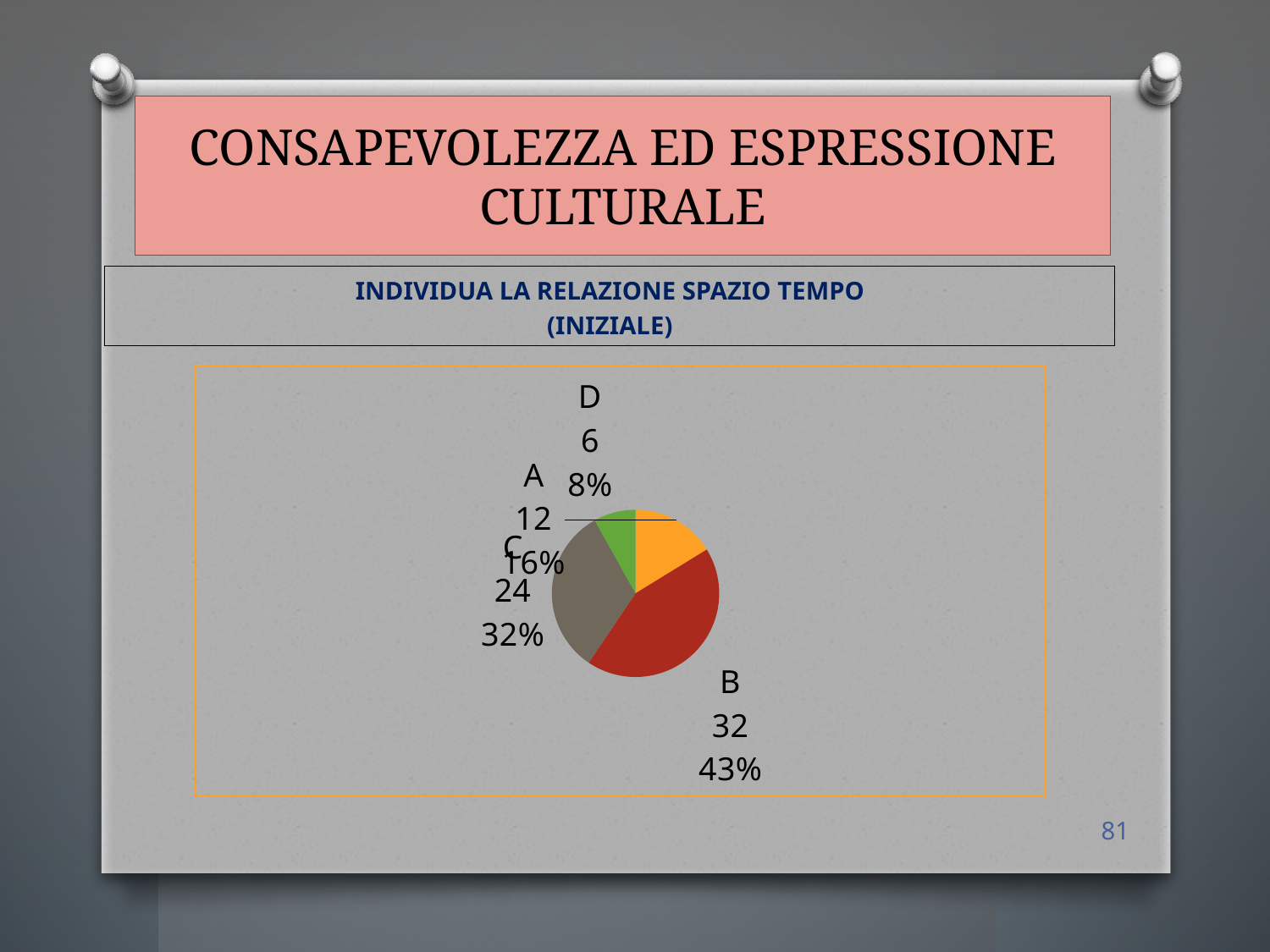
What kind of chart is shown on the slide? pie chart What is the value for category D? 6 What is the difference between the values for B and C? 8 Which is larger, the value for A or the value for C? C What is the value for category C? 24 Which category has the smallest slice? D What is the title shown above the pie chart? INDIVIDUA LA RELAZIONE SPAZIO TEMPO (INIZIALE) What is the value for category B? 32 Which category has the largest slice? B What percentage share does category B have? 43% How many slices does the pie chart have? 4 What percentage share does category A have? 16%